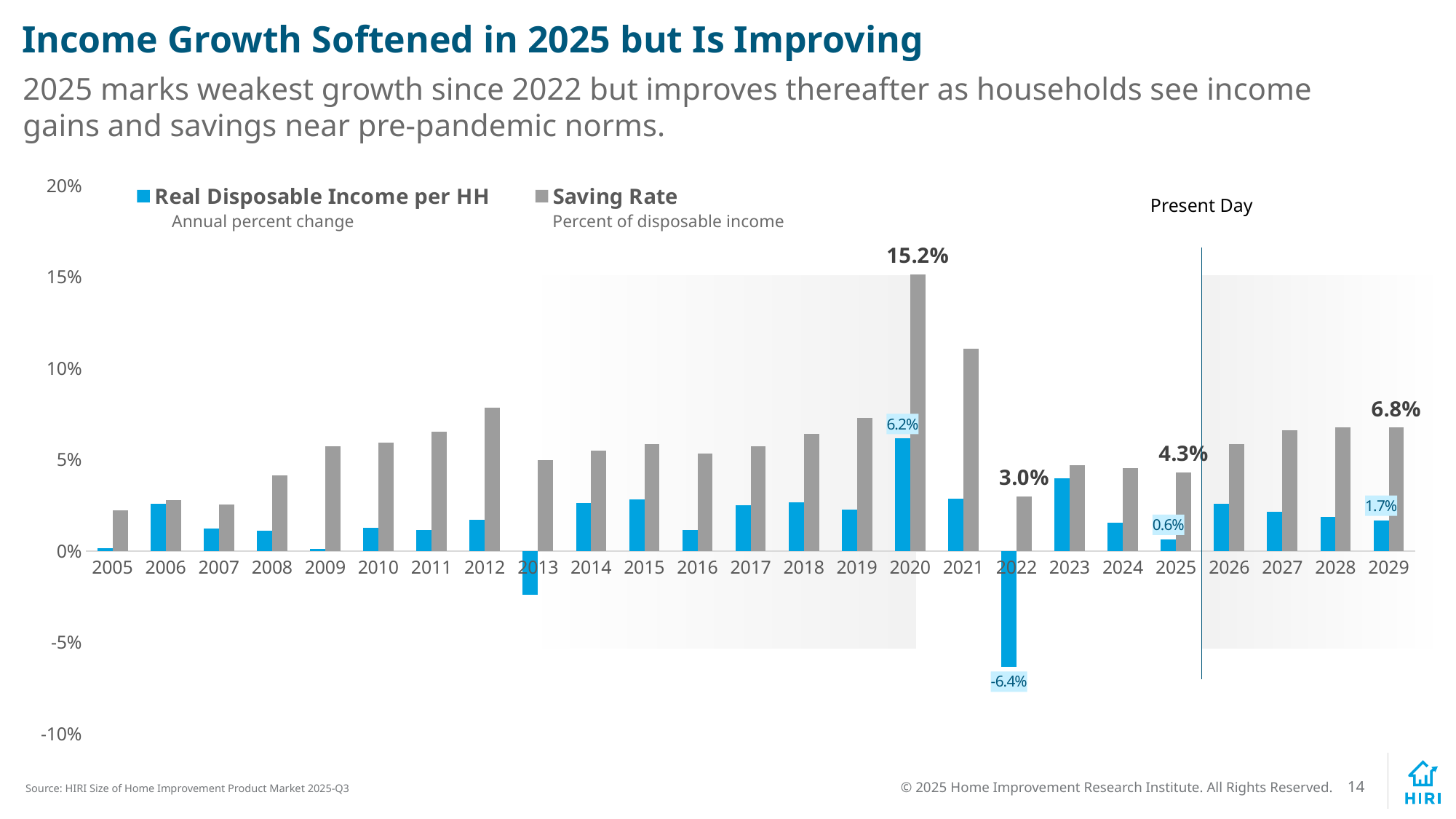
What kind of chart is shown on the slide? bar chart By how much does the Saving Rate in 2029 exceed the Saving Rate in 2025? 2.5 percentage points What is the Real Disposable Income per HH value for 2022? -6.4% In which year is the Saving Rate highest? 2020 What is the Real Disposable Income per HH value for 2025? 0.6% How many years are shown on the x axis? 25 How many series does the legend list? 2 Which year has the larger Real Disposable Income per HH value, 2020 or 2029? 2020 In which year is Real Disposable Income per HH lowest? 2022 Is the Saving Rate for 2021 greater or less than 10%? greater What is the Saving Rate for 2020? 15.2% What is the Saving Rate for 2029? 6.8%